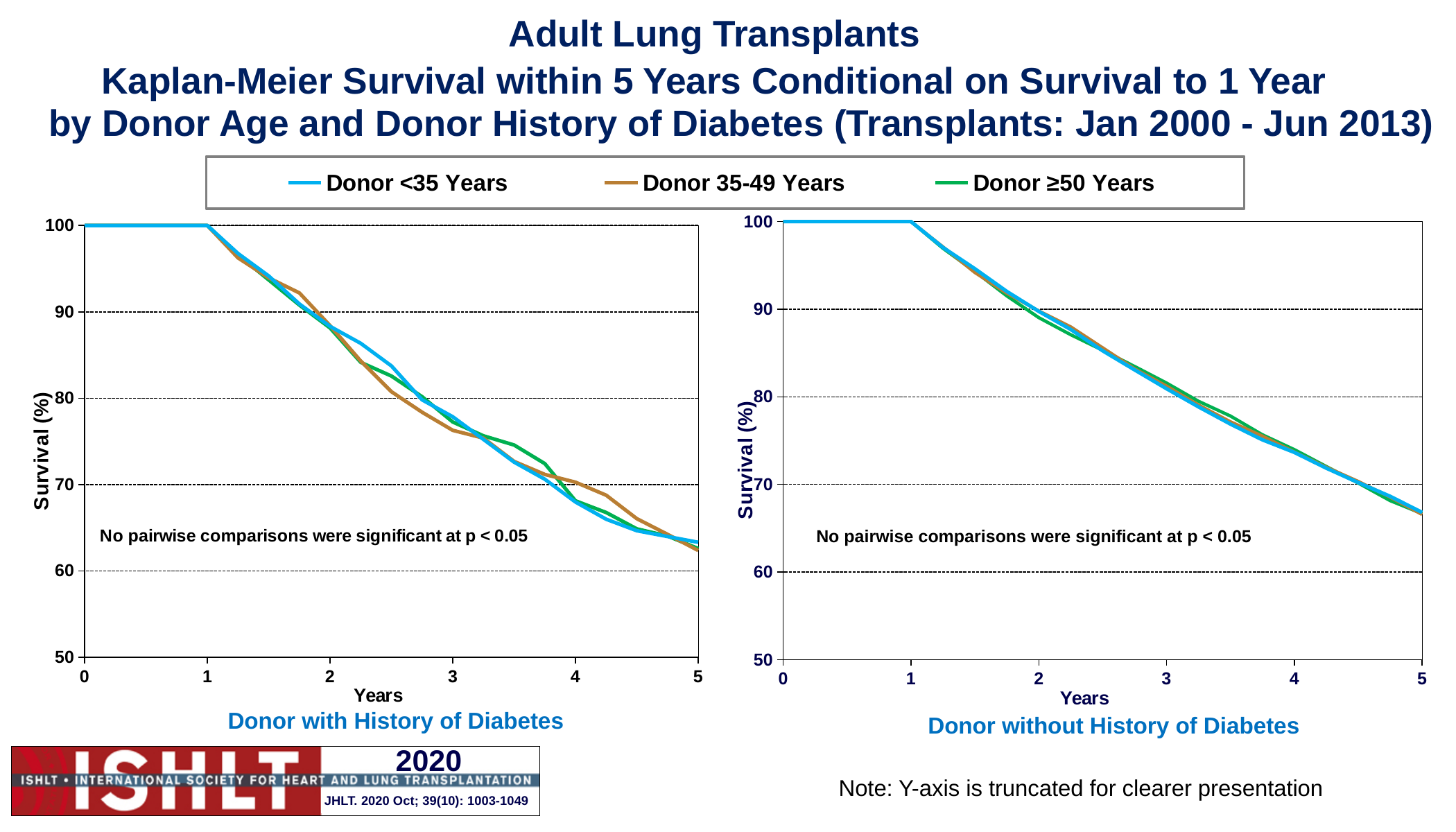
How many series does the legend list? 3 How many year tick marks are labelled on the x-axis of the 'Donor without History of Diabetes' chart? 6 In the 'Donor with History of Diabetes' chart, is the survival value for Donor 35-49 Years at year 5 greater or less than 60? greater In the 'Donor without History of Diabetes' chart, is the survival value for Donor <35 Years at year 5 greater or less than 70? less In the 'Donor with History of Diabetes' chart, what is the survival (%) for Donor <35 Years at year 1? 100 In the 'Donor with History of Diabetes' chart, do the survival curves rise or fall from year 1 to year 5? fall In the 'Donor with History of Diabetes' chart, is the survival value for Donor ≥50 Years at year 3 greater or less than 70? greater What is the lowest value shown on the y-axis of the 'Donor with History of Diabetes' chart? 50 Which colour represents Donor 35-49 Years in the legend? brown In the 'Donor without History of Diabetes' chart, what is the survival (%) for Donor ≥50 Years at year 0? 100 What kind of chart is shown on the left, titled 'Donor with History of Diabetes'? line chart